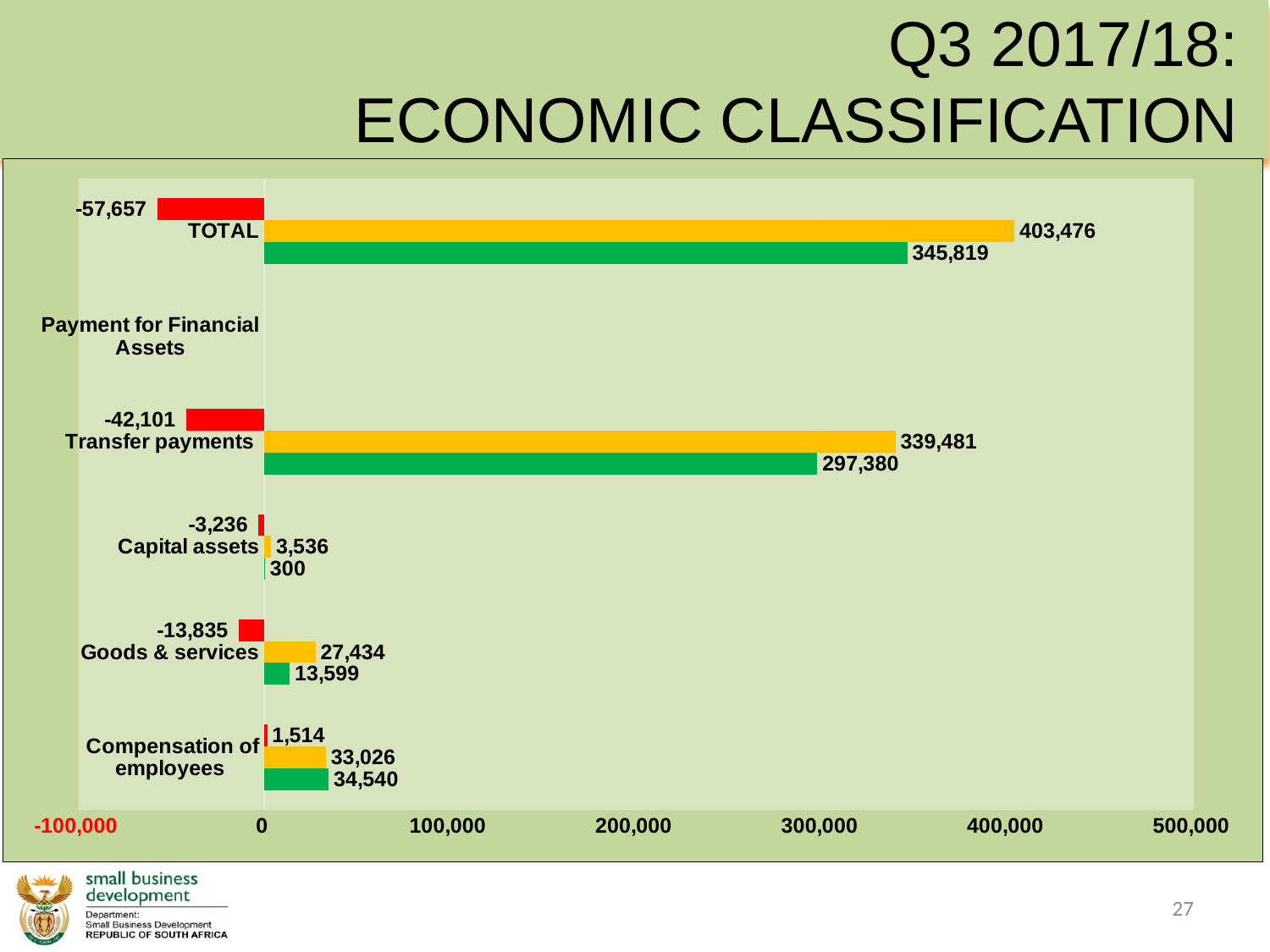
What type of chart is shown on the slide? bar chart How many categories are listed on the vertical axis of the chart? 6 Excluding TOTAL, which category has the highest yellow bar value? Transfer payments What is the difference between the yellow bar and the green bar for TOTAL? 57,657 What is the value of the green bar for Capital assets? 300 What is the value of the yellow bar for Transfer payments? 339,481 Which is larger for Compensation of employees, the yellow bar or the green bar? the green bar What is the value of the green bar for Compensation of employees? 34,540 What is the difference between the yellow bar and the green bar for Goods & services? 13,835 Excluding TOTAL, which category has the lowest green bar value? Capital assets What is the value of the red bar for TOTAL? -57,657 Is the green bar value for Transfer payments greater or less than 300,000? less